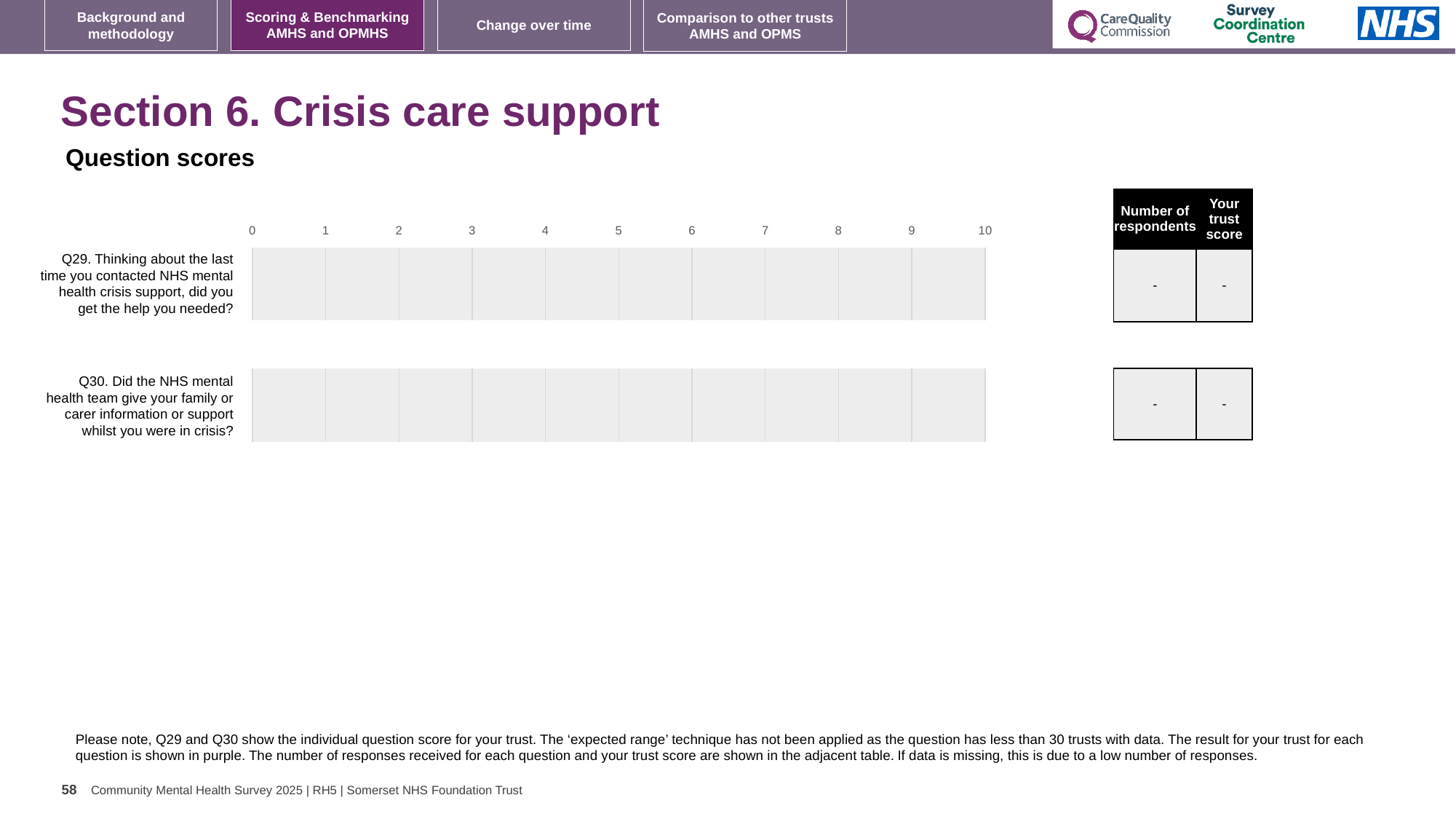
What is the 'Your trust score' value shown in the table for Q29? - How many questions (categories) are listed on the chart? 2 What is the lowest value shown on the chart's x axis? 0 What kind of chart is shown on the slide? bar chart What is the highest value shown on the chart's x axis? 10 What is the 'Number of respondents' value shown in the table for Q29? - What is the 'Your trust score' value shown in the table for Q30? - What is the 'Number of respondents' value shown in the table for Q30? - Are any bars plotted for Q29 or Q30 on the chart? No